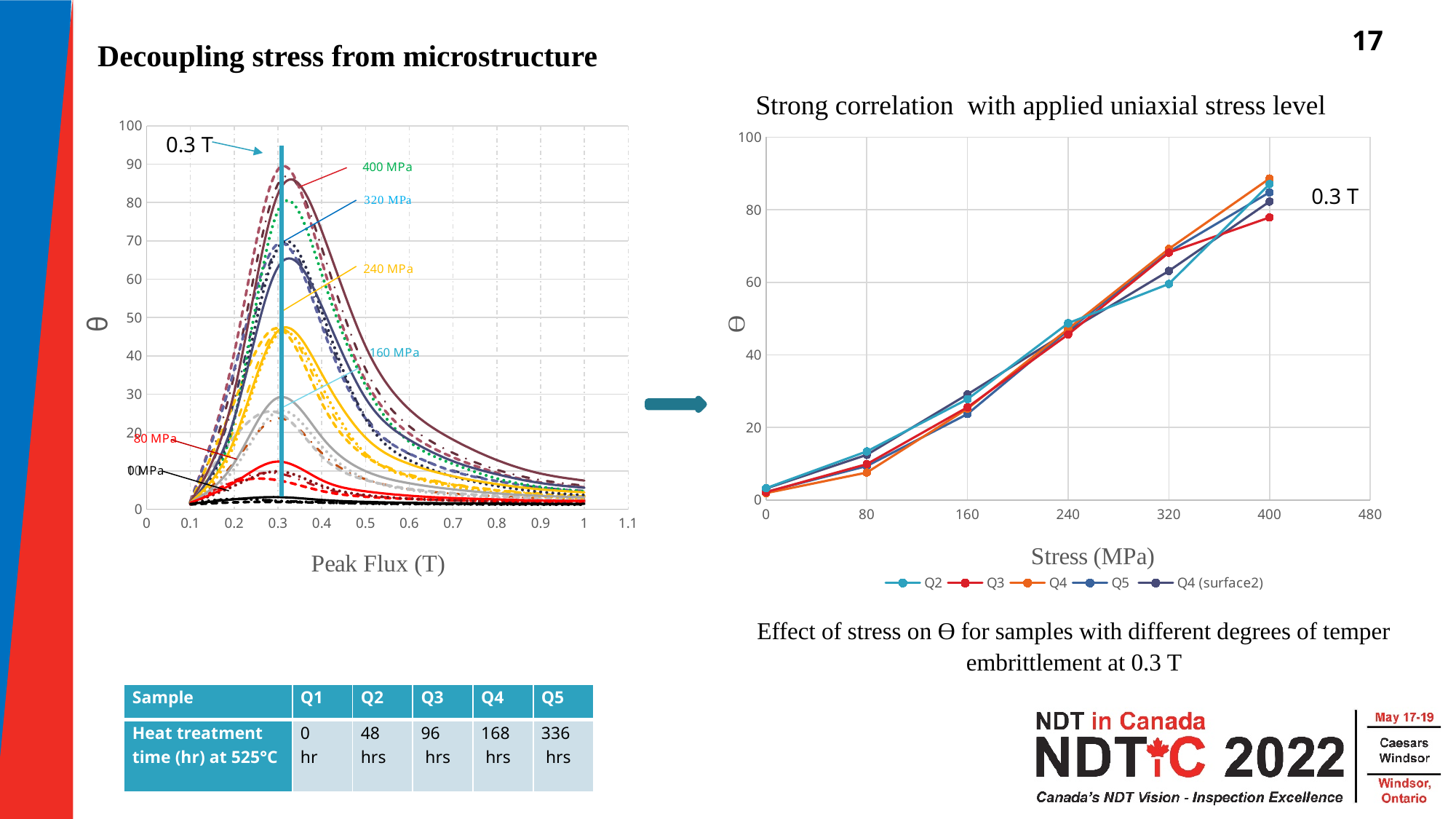
How many series does the legend of the right-hand chart list? 5 In the left-hand chart, what is the label of the x axis? Peak Flux (T) In the left-hand chart, is the peak value of the 400 MPa curve greater or less than 80? greater What kind of chart is the right-hand chart titled 'Strong correlation with applied uniaxial stress level'? line chart In the right-hand chart, what is the label of the x axis? Stress (MPa) In the right-hand chart, is the value of Q4 at 400 MPa greater or less than 80? greater In the right-hand chart, do the Θ values rise or fall as stress increases from 0 to 400 MPa? rise In the right-hand chart, how many stress levels are plotted for each series? 6 In the right-hand chart, is the value of Q3 at 80 MPa greater or less than 20? less In the right-hand chart, at 400 MPa, which is larger: Q4 or Q3? Q4 In the right-hand chart, which series has the lowest value at 400 MPa? Q3